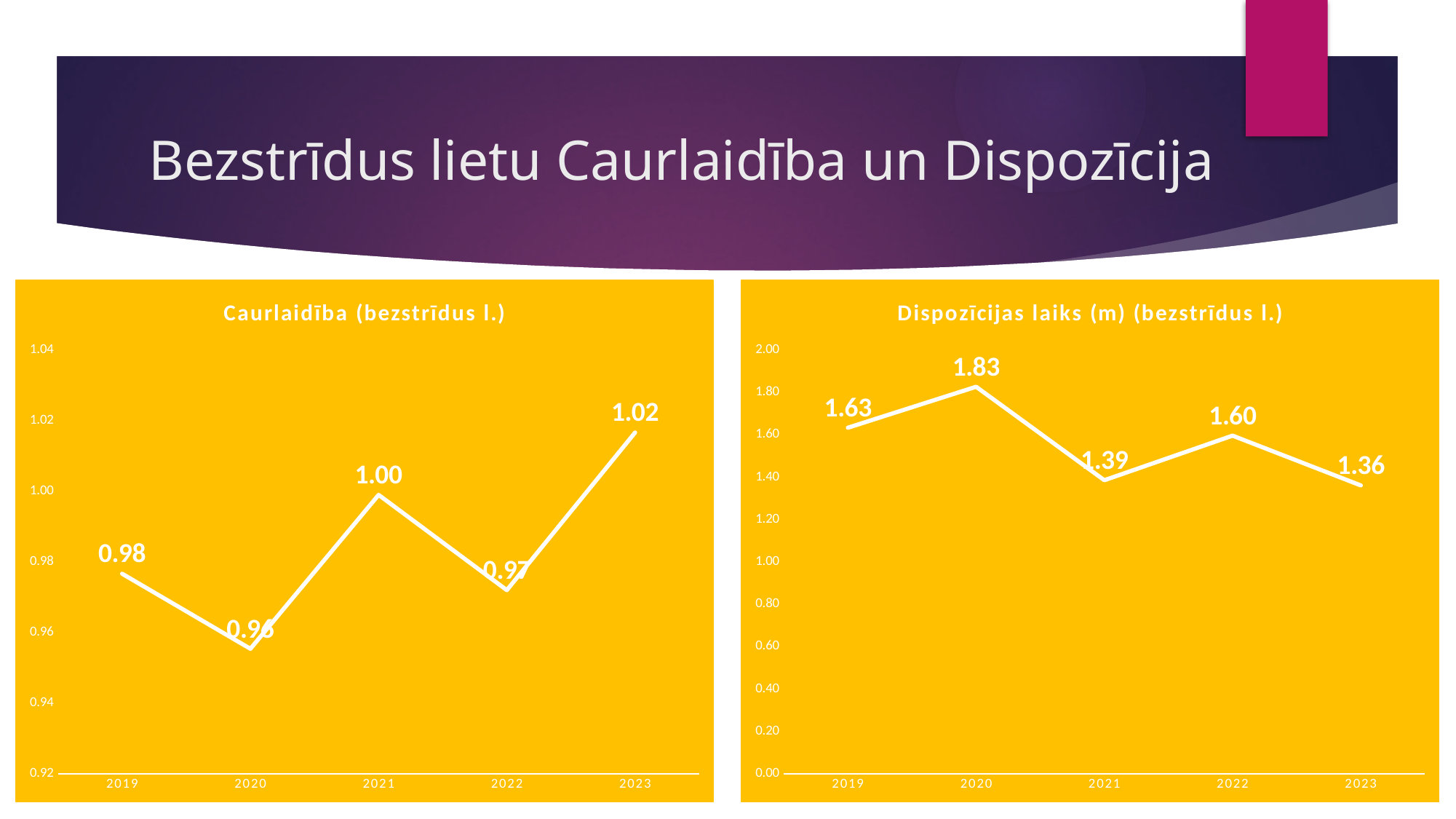
In the chart titled "Caurlaidība (bezstrīdus l.)", which year has the lowest value? 2020 In the chart titled "Caurlaidība (bezstrīdus l.)", what is the difference between the 2023 value and the 2019 value? 0.04 In the chart titled "Dispozīcijas laiks (m) (bezstrīdus l.)", what is the value for 2023? 1.36 In the chart titled "Dispozīcijas laiks (m) (bezstrīdus l.)", what is the value for 2020? 1.83 In the chart titled "Dispozīcijas laiks (m) (bezstrīdus l.)", what is the difference between the 2020 value and the 2021 value? 0.44 In the chart titled "Dispozīcijas laiks (m) (bezstrīdus l.)", which is larger, the value for 2019 or the value for 2022? 2019 In the chart titled "Dispozīcijas laiks (m) (bezstrīdus l.)", which year has the highest value? 2020 In the chart titled "Caurlaidība (bezstrīdus l.)", which year has the highest value? 2023 How many years are plotted in the chart titled "Dispozīcijas laiks (m) (bezstrīdus l.)"? 5 In the chart titled "Caurlaidība (bezstrīdus l.)", what is the value for 2021? 1.00 What type of chart is the chart on the left of the slide? Line chart In the chart titled "Caurlaidība (bezstrīdus l.)", what is the value for 2023? 1.02